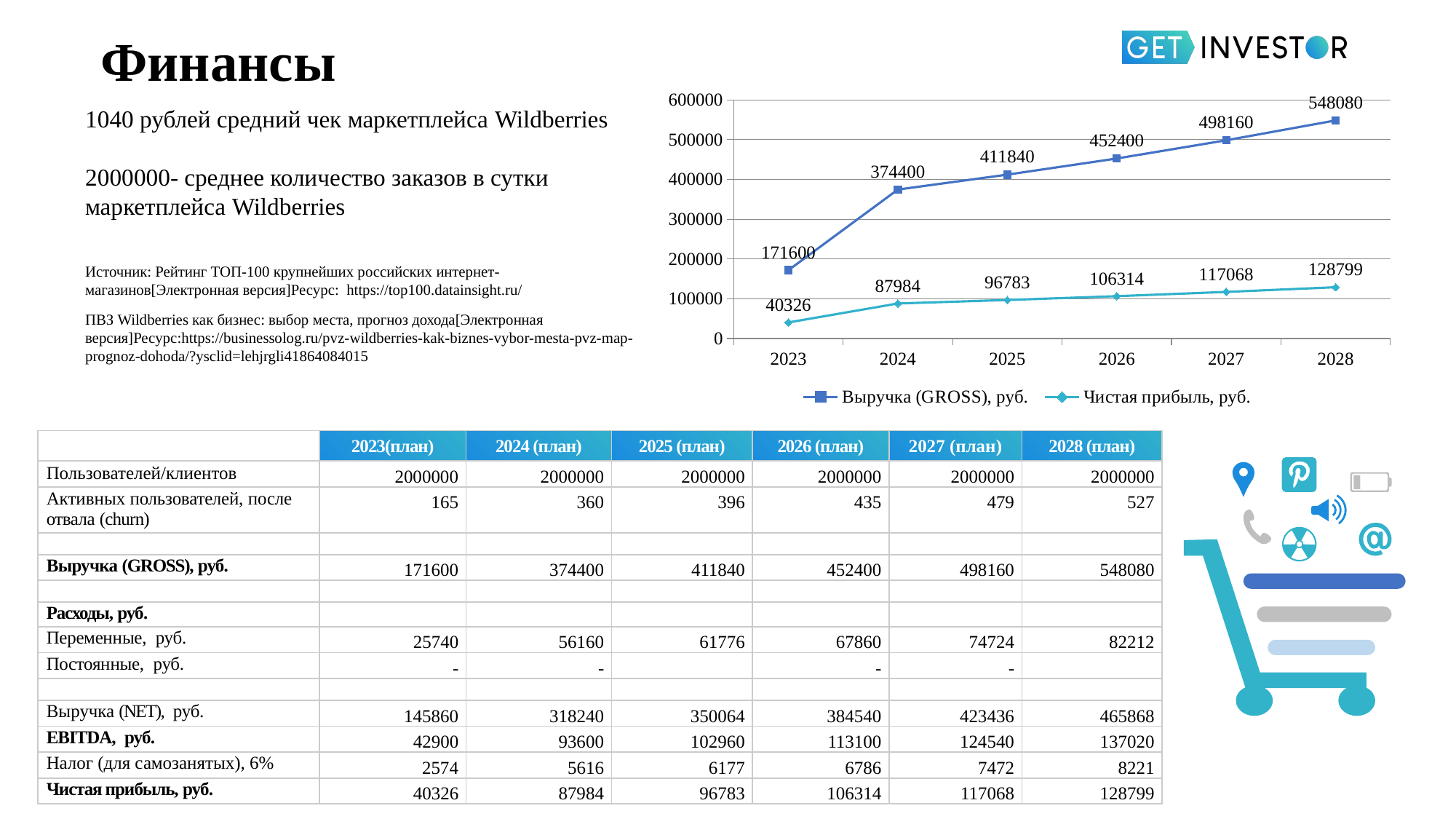
In which year is Чистая прибыль, руб. lowest? 2023 What is the difference between Выручка (GROSS), руб. in 2028 and in 2023? 376480 Is the value of Выручка (GROSS), руб. for 2027 greater or less than 400000? greater Which is larger: Чистая прибыль, руб. in 2026 or Чистая прибыль, руб. in 2025? 2026 In which year is Выручка (GROSS), руб. highest? 2028 What kind of chart is shown on the slide? line chart How many years are shown on the x axis of the chart? 6 How many series does the chart legend list? 2 What is the value of Выручка (GROSS), руб. for 2025? 411840 Does Чистая прибыль, руб. rise or fall from 2023 to 2028? rise What is the difference between Выручка (GROSS), руб. and Чистая прибыль, руб. in 2024? 286416 What is the value of Чистая прибыль, руб. for 2027? 117068